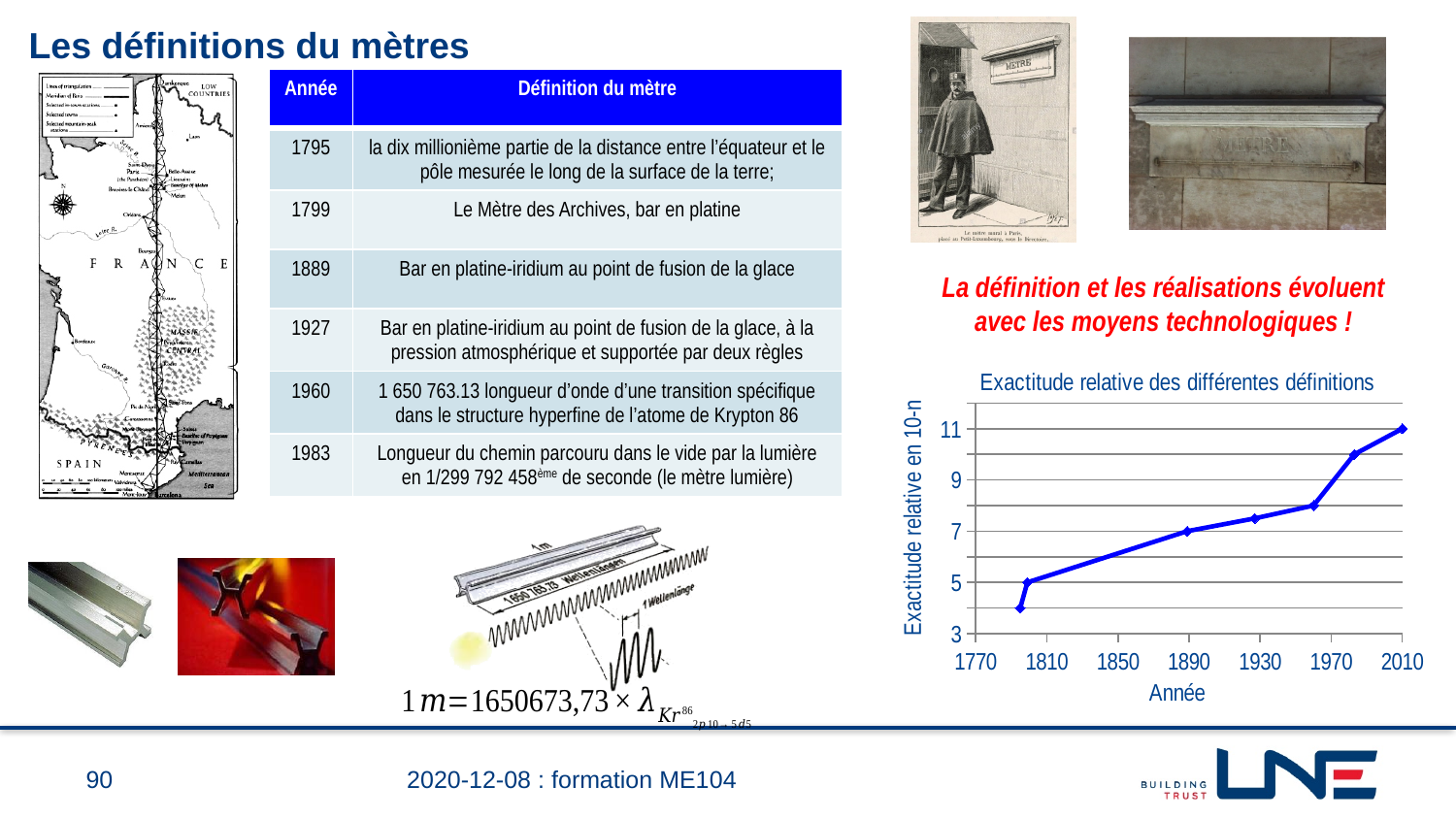
How many data points are plotted on the line in the chart? 7 Is the value of the earliest data point (just before 1810) greater or less than 5? less Is the value of the data point near 1890 greater or less than 5? greater What is the title of the chart on the slide? Exactitude relative des différentes définitions Which data point has the highest value on the chart? the point at 2010 Which data point has the lowest value on the chart? the earliest point, just before 1810 What is the label of the x axis of the chart? Année What kind of chart is shown on the slide? line chart Is the value of the data point near 1960 greater or less than 9? less What is the value of the last data point, at the year 2010? 11 Which is larger: the value of the point near 1930 or the value of the point near 1980? the point near 1980 Do the values on the chart rise or fall as the year increases along the x axis? rise